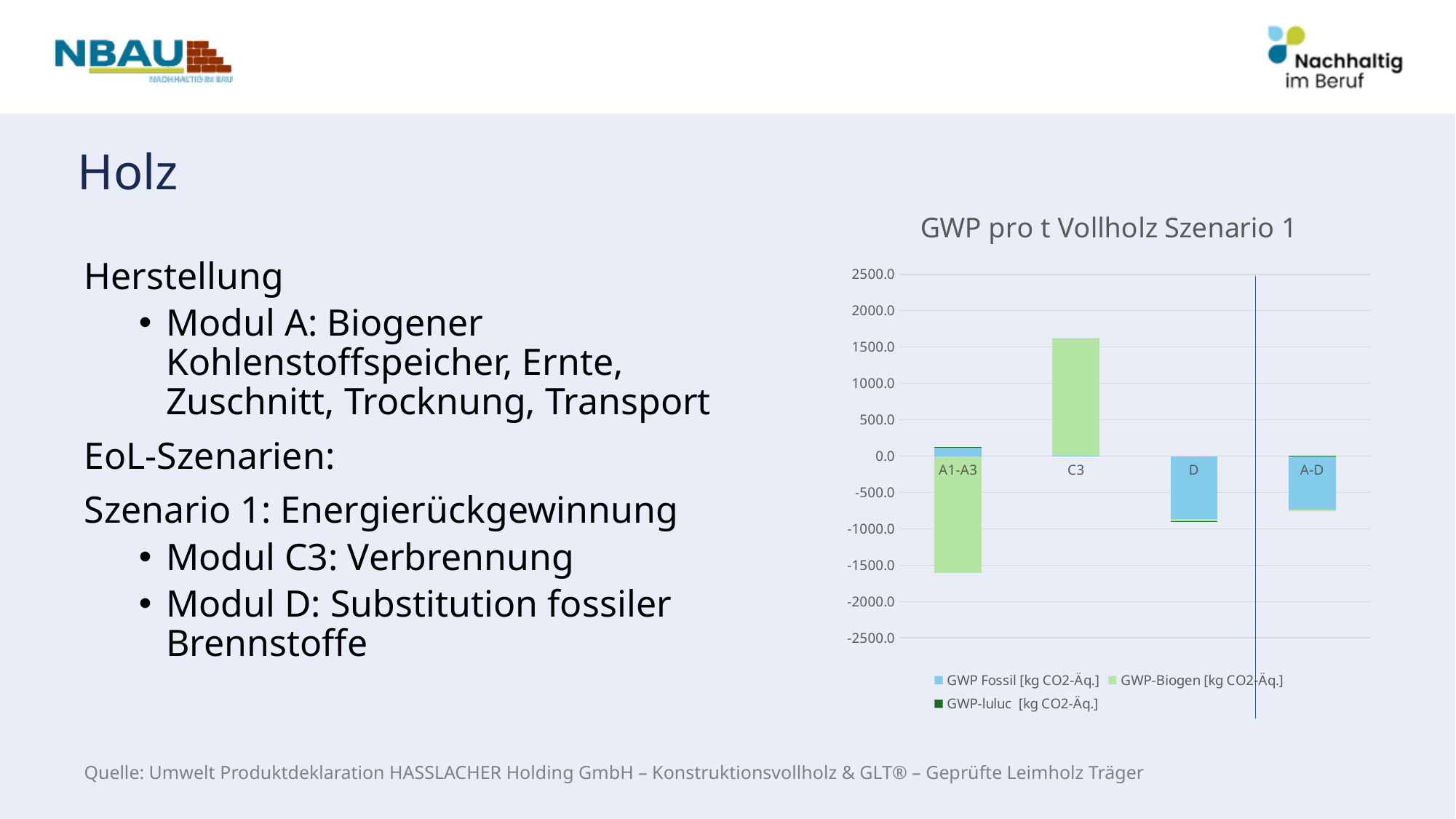
Which series in the chart is shown in light blue? GWP Fossil [kg CO2-Äq.] Is the GWP-Biogen value for C3 greater or less than 1000.0? greater What is the title of the chart? GWP pro t Vollholz Szenario 1 What kind of chart is shown on the slide? bar chart Is the GWP Fossil value for A-D greater or less than -500.0? less Is the GWP-Biogen value for A1-A3 greater or less than -1000.0? less Which is larger, the GWP-Biogen value for C3 or the GWP-Biogen value for A1-A3? C3 Which category has the highest positive bar in the chart? C3 Which category has the most negative bar in the chart? A1-A3 How many series does the chart legend list? 3 How many categories are shown on the x axis of the chart? 4